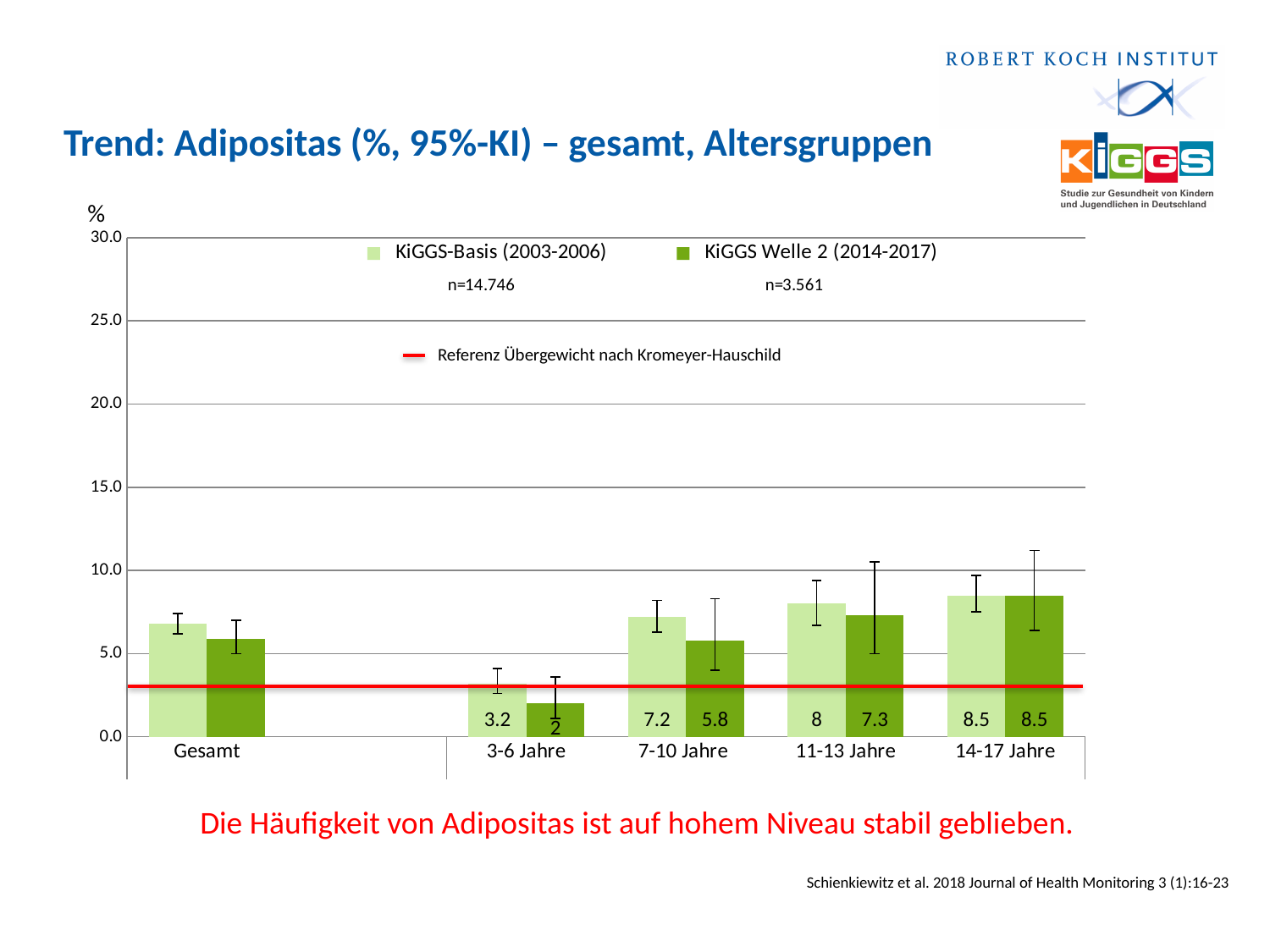
What is the value for KiGGS Welle 2 (2014-2017) in the 3-6 Jahre age group? 2 What kind of chart is shown on the slide? bar chart What is the difference between the KiGGS-Basis (2003-2006) and KiGGS Welle 2 (2014-2017) values for 7-10 Jahre? 1.4 What is the value for KiGGS-Basis (2003-2006) in the 7-10 Jahre age group? 7.2 What is the value for KiGGS Welle 2 (2014-2017) in the 11-13 Jahre age group? 7.3 Is the KiGGS-Basis (2003-2006) value for Gesamt greater or less than 5.0? greater Which age group has the highest KiGGS-Basis (2003-2006) value? 14-17 Jahre What sample size (n) is given for KiGGS-Basis (2003-2006) in the legend? n=14.746 How many bar series does the legend list? 2 How many categories are shown on the x axis? 5 Which category has the lowest KiGGS Welle 2 (2014-2017) value? 3-6 Jahre For 11-13 Jahre, which series has the larger value, KiGGS-Basis (2003-2006) or KiGGS Welle 2 (2014-2017)? KiGGS-Basis (2003-2006)